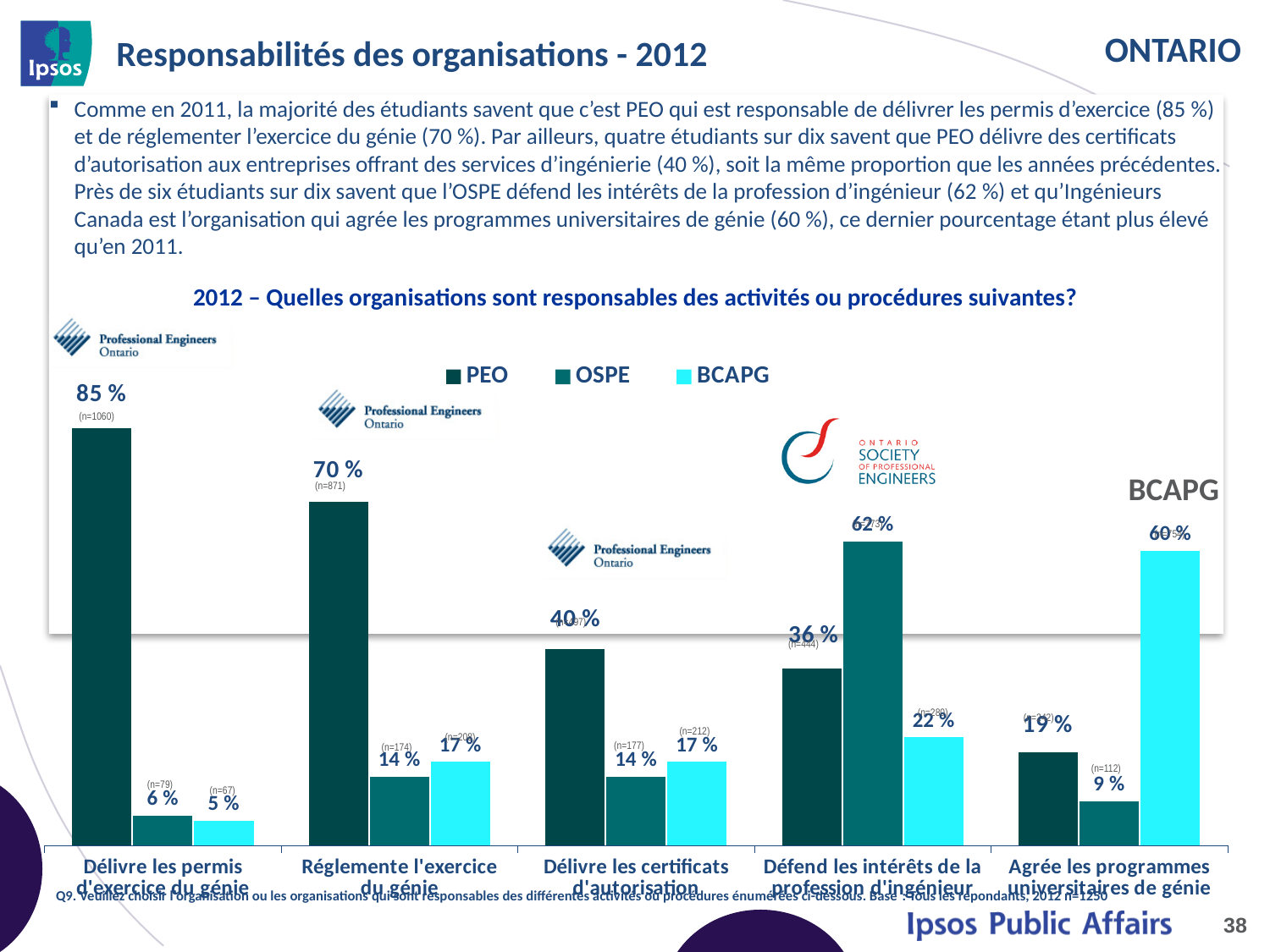
What are the three series listed in the chart legend? PEO, OSPE, BCAPG Which category has the highest PEO value? Délivre les permis d'exercice du génie What kind of chart is shown on the slide? Bar chart How many categories are shown on the x axis of the chart? 5 How many series does the chart legend list? 3 Which category has the lowest BCAPG value? Délivre les permis d'exercice du génie What is the BCAPG value for "Agrée les programmes universitaires de génie"? 60 % For "Défend les intérêts de la profession d'ingénieur", which is larger: the PEO value or the OSPE value? OSPE What is the difference between the PEO value for "Délivre les permis d'exercice du génie" and the PEO value for "Réglemente l'exercice du génie"? 15 % What is the OSPE value for "Défend les intérêts de la profession d'ingénieur"? 62 % What is the PEO value for "Délivre les certificats d'autorisation"? 40 % What is the PEO value for "Délivre les permis d'exercice du génie"? 85 %